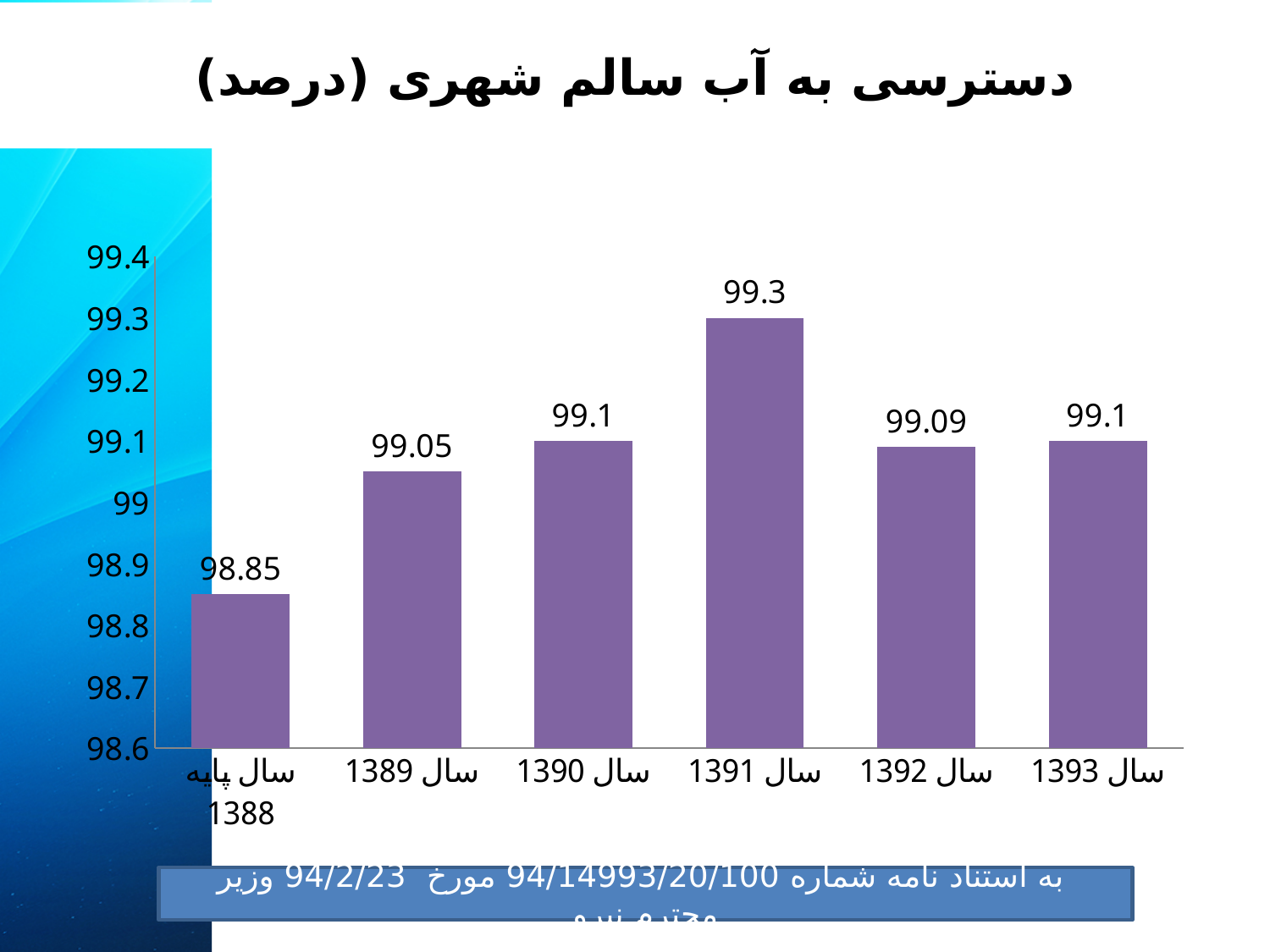
What is the difference between the values for سال 1390 and سال 1389? 0.05 What is the title of the chart? دسترسی به آب سالم شهری (درصد) What is the value for سال 1389? 99.05 What is the value for سال 1392? 99.09 How many years (bars) are shown in the chart? 6 What kind of chart is shown on the slide? Bar chart Which year has the highest value? سال 1391 What is the difference between the values for سال 1391 and سال پایه 1388? 0.45 What is the value for سال 1391? 99.3 Which is larger, the value for سال 1391 or the value for سال 1393? سال 1391 What is the value for the base year (سال پایه 1388)? 98.85 Which year has the lowest value? سال پایه 1388